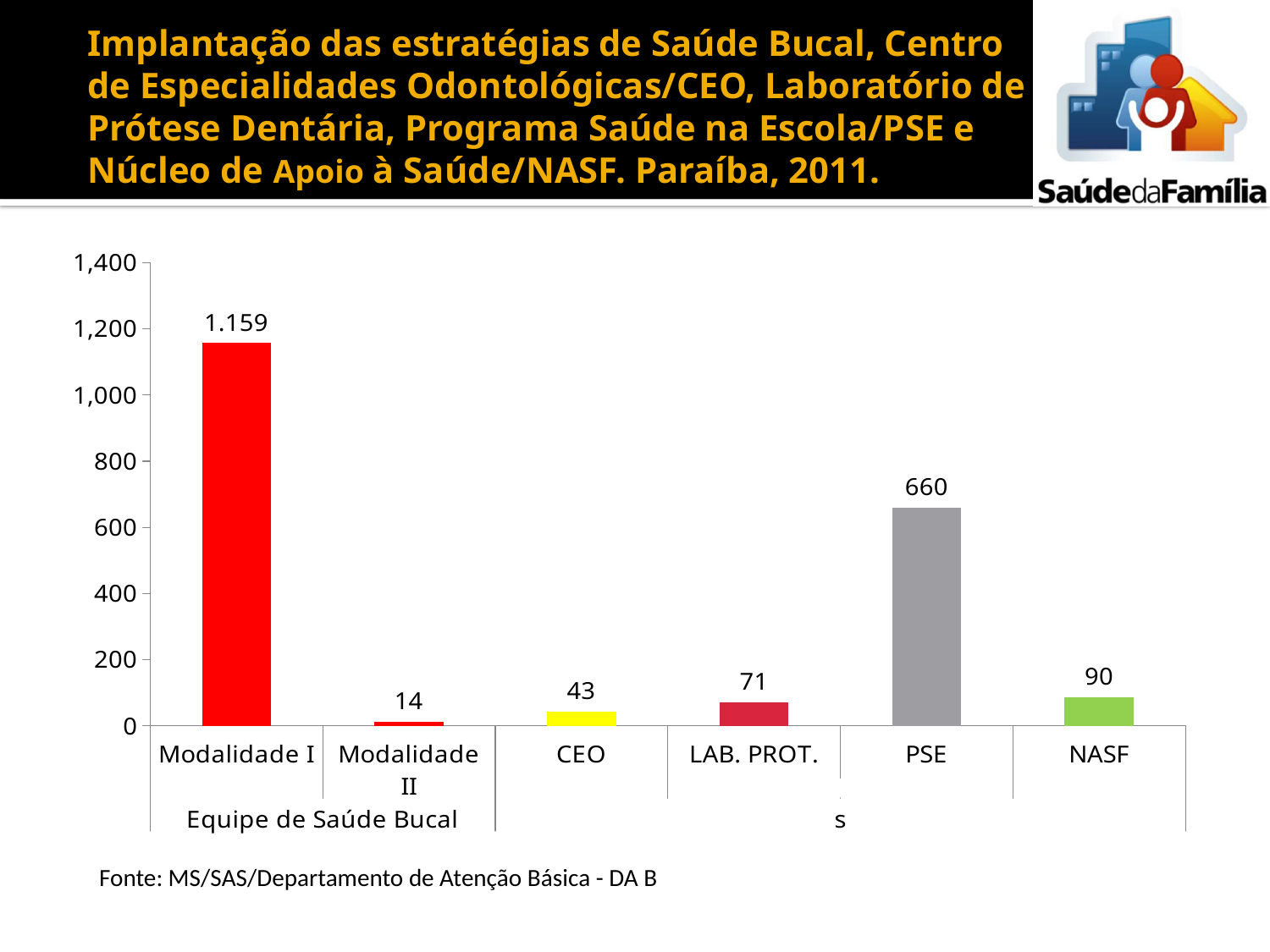
Which category has the lowest value? Modalidade II Which category has the highest value? Modalidade I What is the difference between the values for LAB. PROT. and CEO? 28 What is the difference between the values for PSE and NASF? 570 What is the value for NASF? 90 What is the value for LAB. PROT.? 71 What is the value for PSE? 660 Which is larger, the value for NASF or the value for LAB. PROT.? NASF How many categories are shown in the chart? 6 What kind of chart is shown on the slide? Bar chart What is the value for Modalidade I? 1.159 What is the value for CEO? 43